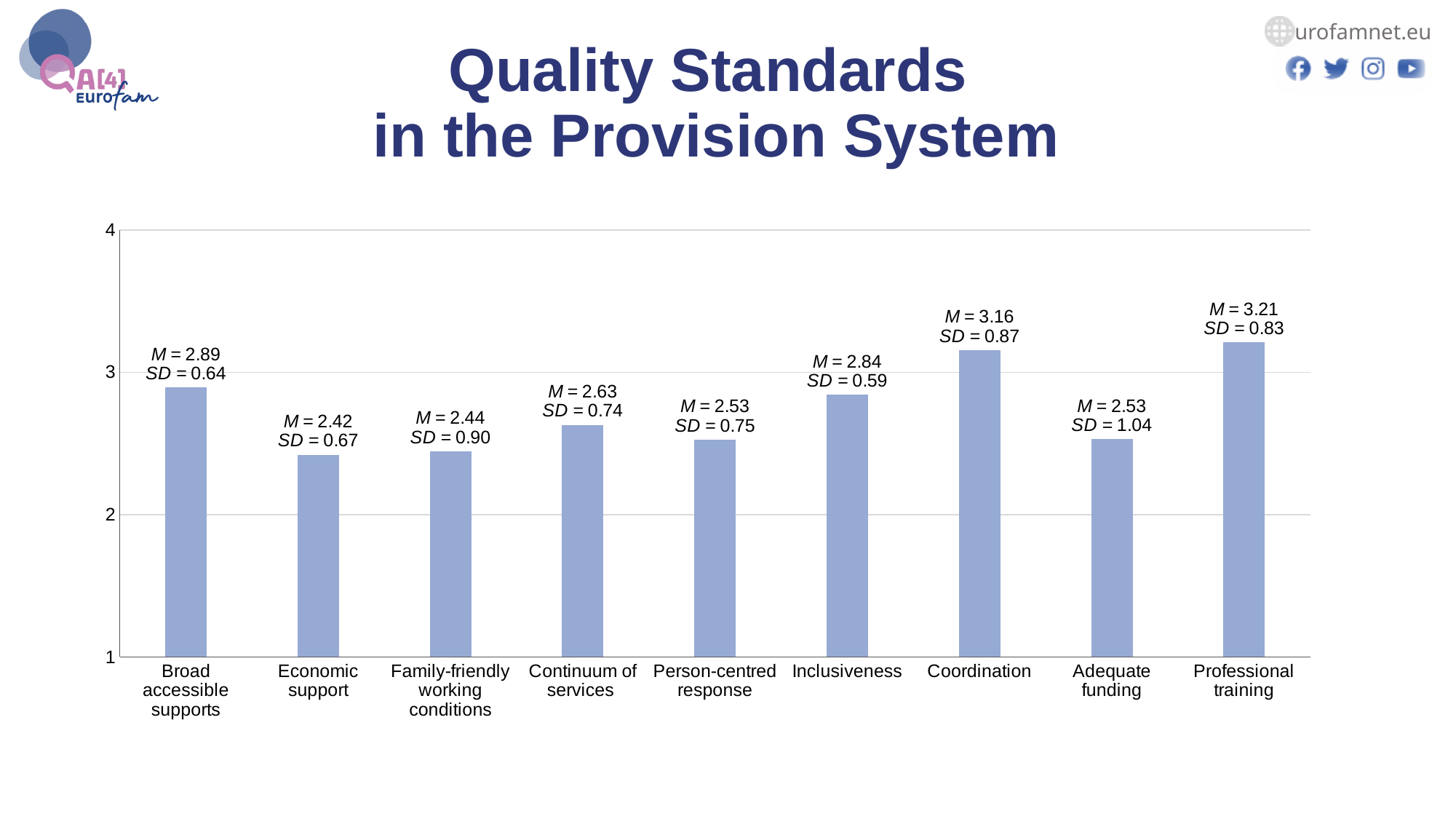
How many categories are shown on the x axis? 9 What is the difference between the mean values for Coordination and Inclusiveness? 0.32 Which category has the lowest mean value? Economic support What is the SD value for Adequate funding? 1.04 Which has a larger mean value, Broad accessible supports or Continuum of services? Broad accessible supports What kind of chart is shown on the slide? Bar chart What is the mean (M) value for Coordination? 3.16 Which category has the highest mean value? Professional training What is the difference between the mean values for Professional training and Economic support? 0.79 Is the mean value for Coordination greater or less than 3? greater What is the title of the slide? Quality Standards in the Provision System What is the mean (M) value for Inclusiveness? 2.84